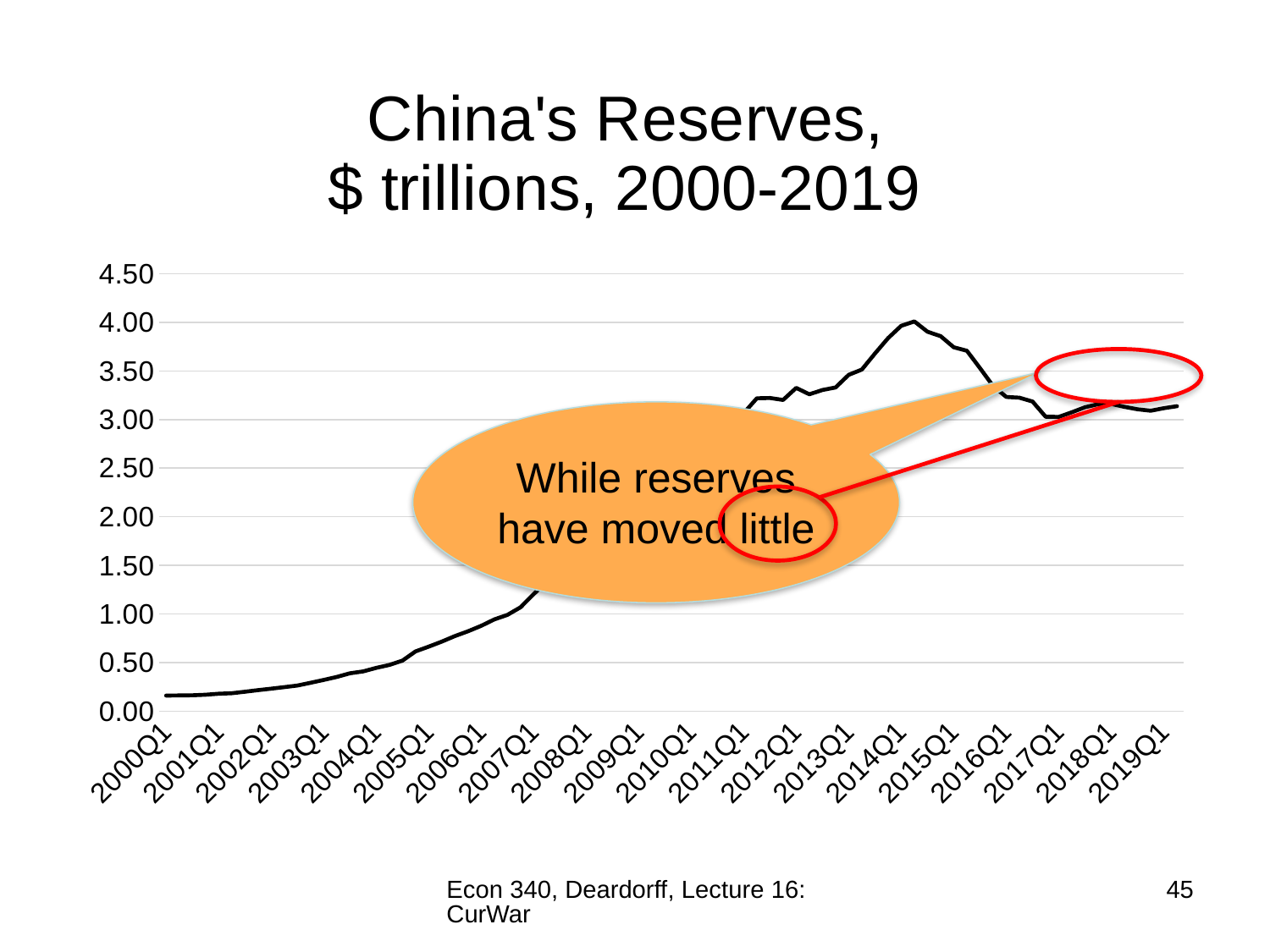
Which is larger, the value for 2000Q1 or the value for 2005Q1? 2005Q1 Is the value for 2000Q1 greater or less than 0.50? less What is the highest value shown on the y axis? 4.50 Is the value for 2007Q1 greater or less than 1.00? greater How many year labels are shown on the x axis? 20 Is the value for 2003Q1 greater or less than 0.50? less Do China's reserves rise or fall between 2000Q1 and 2014Q1? rise What kind of chart is shown on the slide? line chart Which is larger, the value for 2014Q1 or the value for 2019Q1? 2014Q1 What is the title of the chart? China's Reserves, $ trillions, 2000-2019